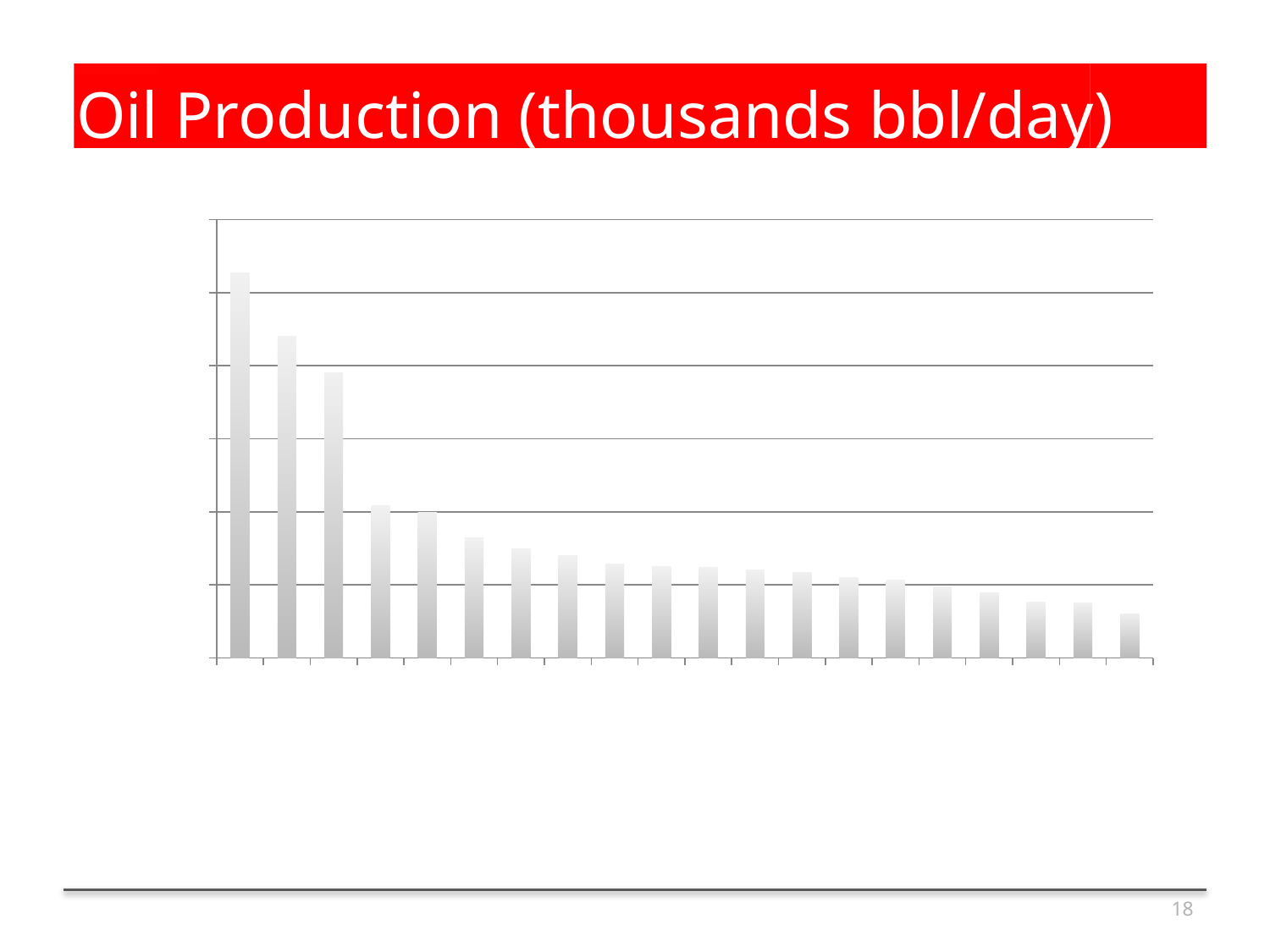
How many bars are plotted in the chart? 20 Does the chart display a legend? No What kind of chart is shown on the slide? bar chart Do the bar values rise or fall from left to right across the chart? fall Which bar is taller, the leftmost bar or the rightmost bar? leftmost What is the title shown above the chart on the slide? Oil Production (thousands bbl/day) Is the tallest bar at the left end or the right end of the chart? left end Is the shortest bar at the left end or the right end of the chart? right end